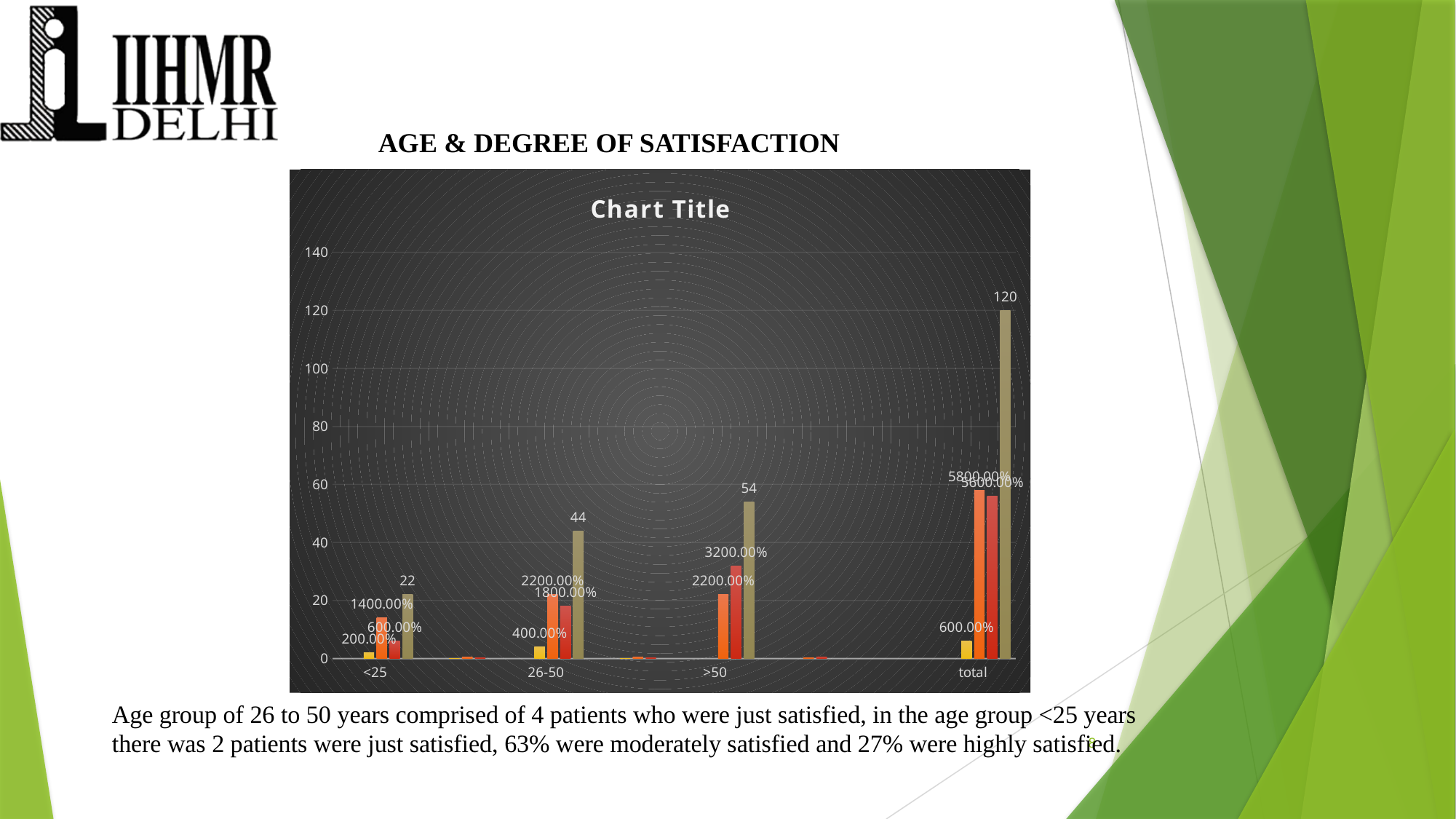
What is the title printed inside the chart? Chart Title Which category has the taller top bar, '26-50' or '>50'? >50 What is the value labelled on the tallest bar in the '26-50' category? 44 What is the difference between the tallest bar in 'total' (120) and the tallest bar in '>50' (54)? 66 What is the value labelled on the tallest bar in the '>50' category? 54 What kind of chart is shown on the slide? bar chart What is the highest value shown on the vertical axis of the chart? 140 Which category contains the tallest bar in the chart? total What is the value labelled on the tallest bar in the '<25' category? 22 How many categories are shown on the x axis of the chart? 4 Do the values of the tallest bars rise or fall moving from '<25' to 'total' along the x axis? rise What is the value labelled on the tallest bar in the 'total' category? 120